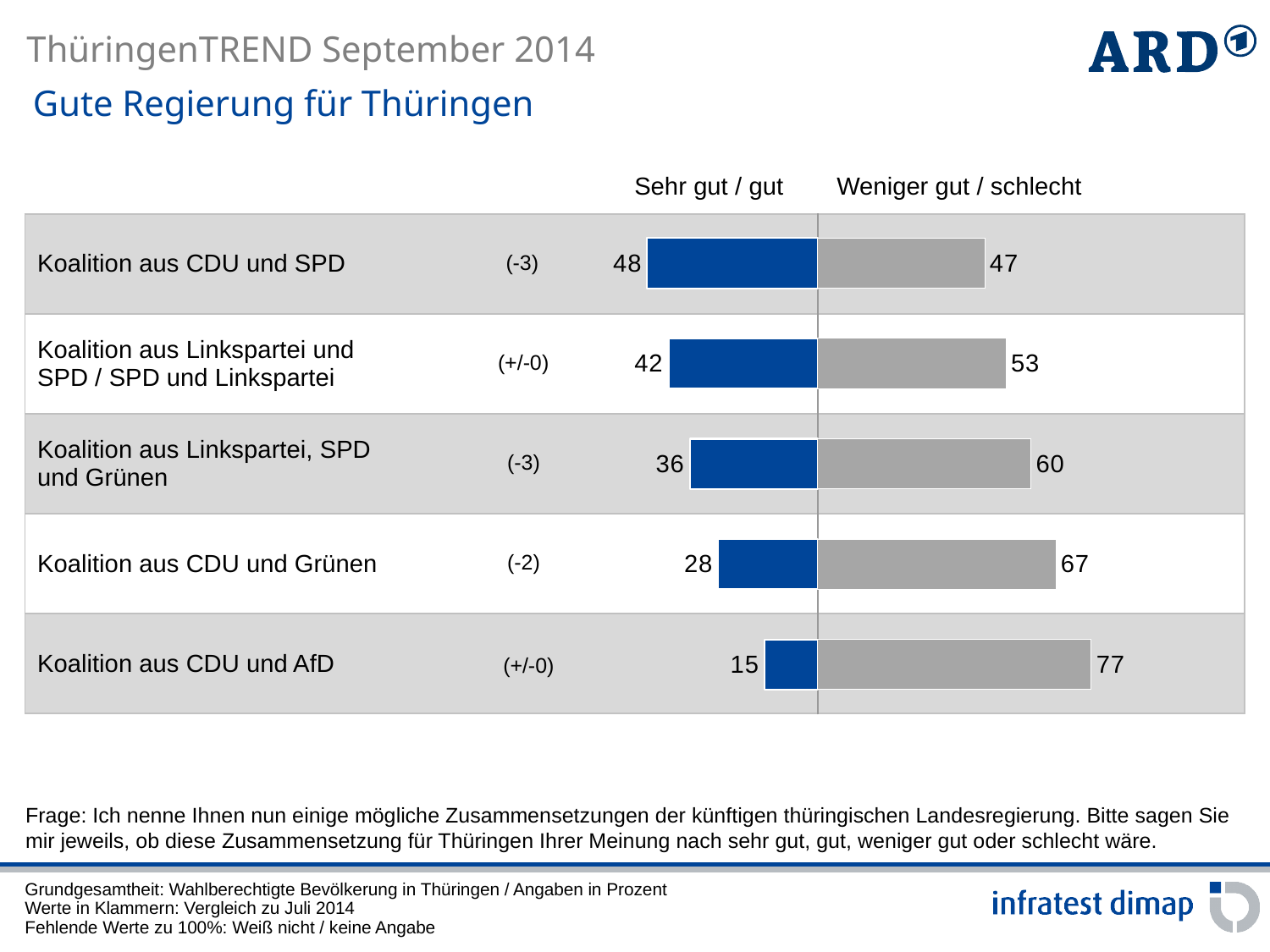
What is the change compared to July 2014 shown in parentheses for 'Koalition aus CDU und Grünen'? (-2) What is the 'Weniger gut / schlecht' value for 'Koalition aus Linkspartei, SPD und Grünen'? 60 Which coalition has the highest 'Weniger gut / schlecht' value? Koalition aus CDU und AfD What kind of chart is shown on the slide? Bar chart How many coalitions are shown in the chart? 5 What is the 'Weniger gut / schlecht' value for 'Koalition aus CDU und AfD'? 77 Which is larger for 'Koalition aus Linkspartei und SPD / SPD und Linkspartei': the 'Sehr gut / gut' value or the 'Weniger gut / schlecht' value? Weniger gut / schlecht Which coalition has the lowest 'Sehr gut / gut' value? Koalition aus CDU und AfD Which coalition has the highest 'Sehr gut / gut' value? Koalition aus CDU und SPD How many series does the chart show? 2 What is the 'Sehr gut / gut' value for 'Koalition aus CDU und SPD'? 48 What is the difference between the 'Weniger gut / schlecht' and 'Sehr gut / gut' values for 'Koalition aus CDU und Grünen'? 39